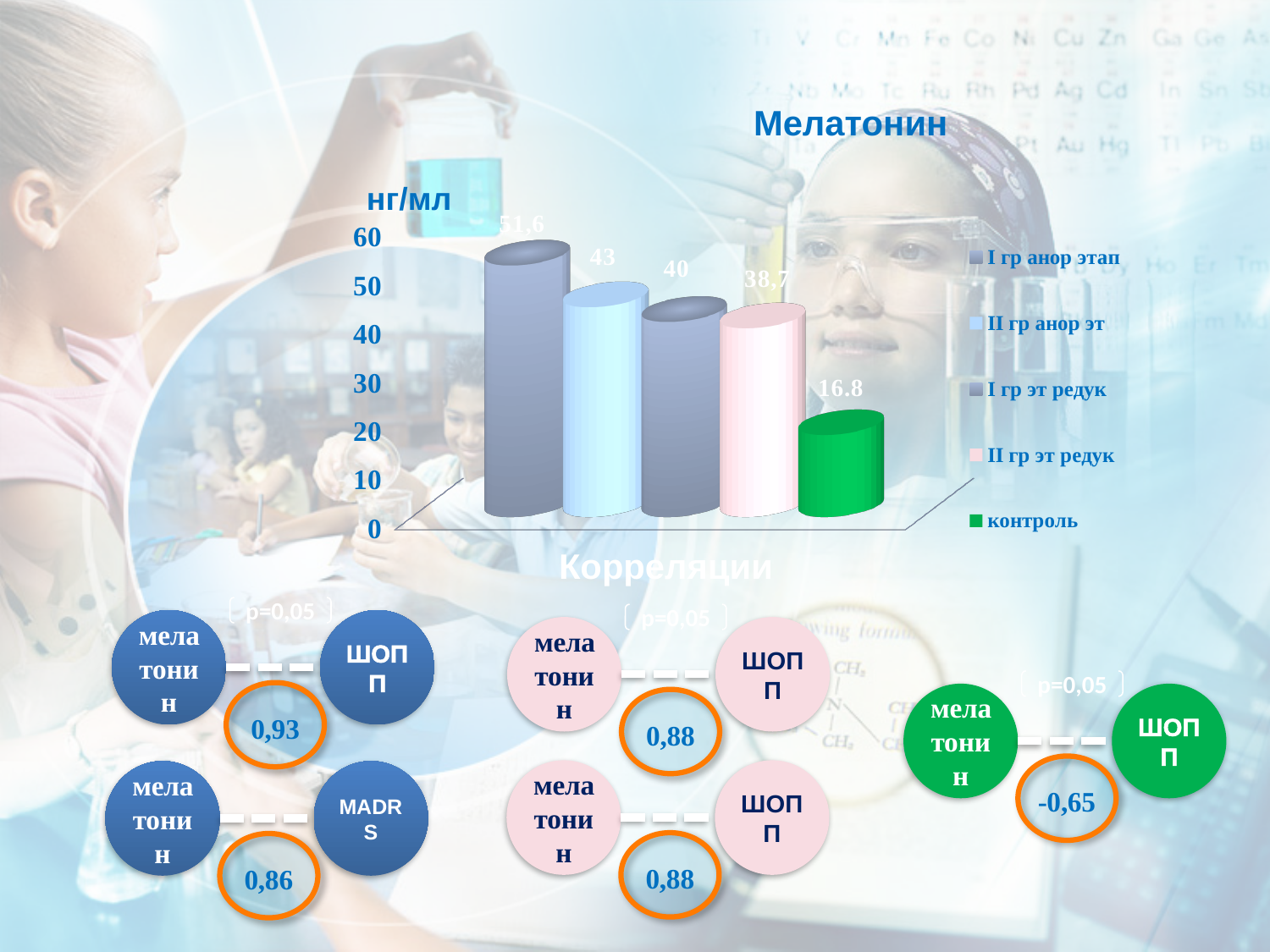
In the 'Мелатонин' chart, what is the value for 'II гр анор эт'? 43 In the 'Мелатонин' chart, what is the value for 'I гр эт редук'? 40 In the 'Мелатонин' chart, is the value for 'контроль' greater or less than 20? less In the 'Мелатонин' chart, which is larger: 'II гр анор эт' or 'I гр эт редук'? II гр анор эт What type of chart is shown under the title 'Мелатонин'? bar chart In the 'Мелатонин' chart, what is the difference between 'I гр анор этап' and 'II гр анор эт'? 8,6 How many entries does the legend of the 'Мелатонин' chart list? 5 In the 'Мелатонин' chart, what is the value for 'I гр анор этап'? 51,6 What unit is shown on the vertical axis of the 'Мелатонин' chart? нг/мл In the 'Мелатонин' chart, what is the value for 'II гр эт редук'? 38,7 In the 'Мелатонин' chart, which group has the lowest value? контроль In the 'Мелатонин' chart, which group has the highest value? I гр анор этап